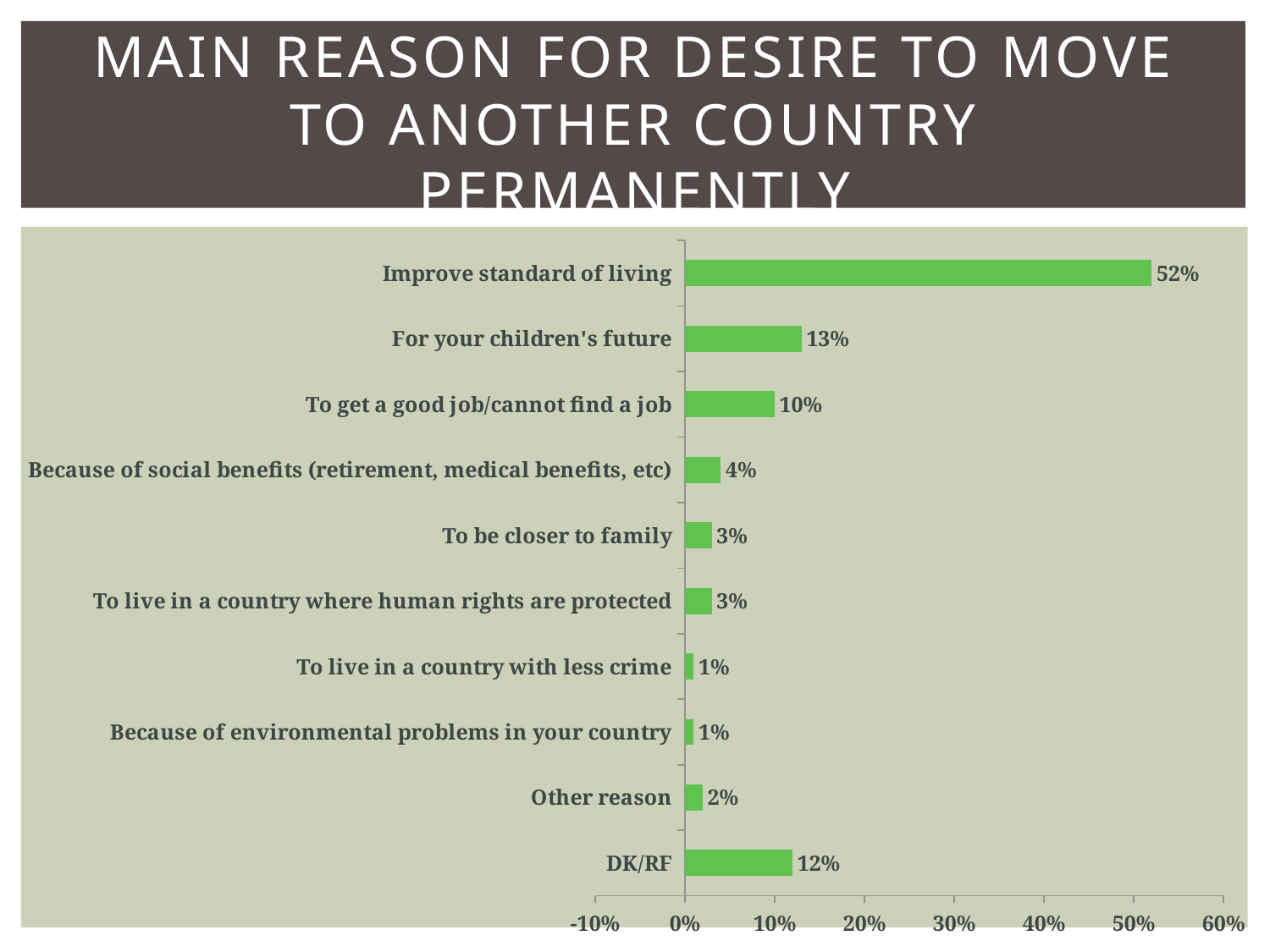
What colour are the bars in the chart? Green What is the value for 'For your children's future'? 13% What is the value for 'Because of social benefits (retirement, medical benefits, etc)'? 4% Which reason has the highest percentage? Improve standard of living How many reason categories are plotted in the chart? 10 What is the difference between 'Improve standard of living' and 'For your children's future'? 39% What percentage is shown for 'Improve standard of living'? 52% Which is larger: 'To get a good job/cannot find a job' or 'To be closer to family'? To get a good job/cannot find a job What is the difference between 'To get a good job/cannot find a job' and 'Other reason'? 8% What kind of chart is shown on the slide? Bar chart Which is larger: 'For your children's future' or 'DK/RF'? For your children's future What percentage is shown for 'DK/RF'? 12%